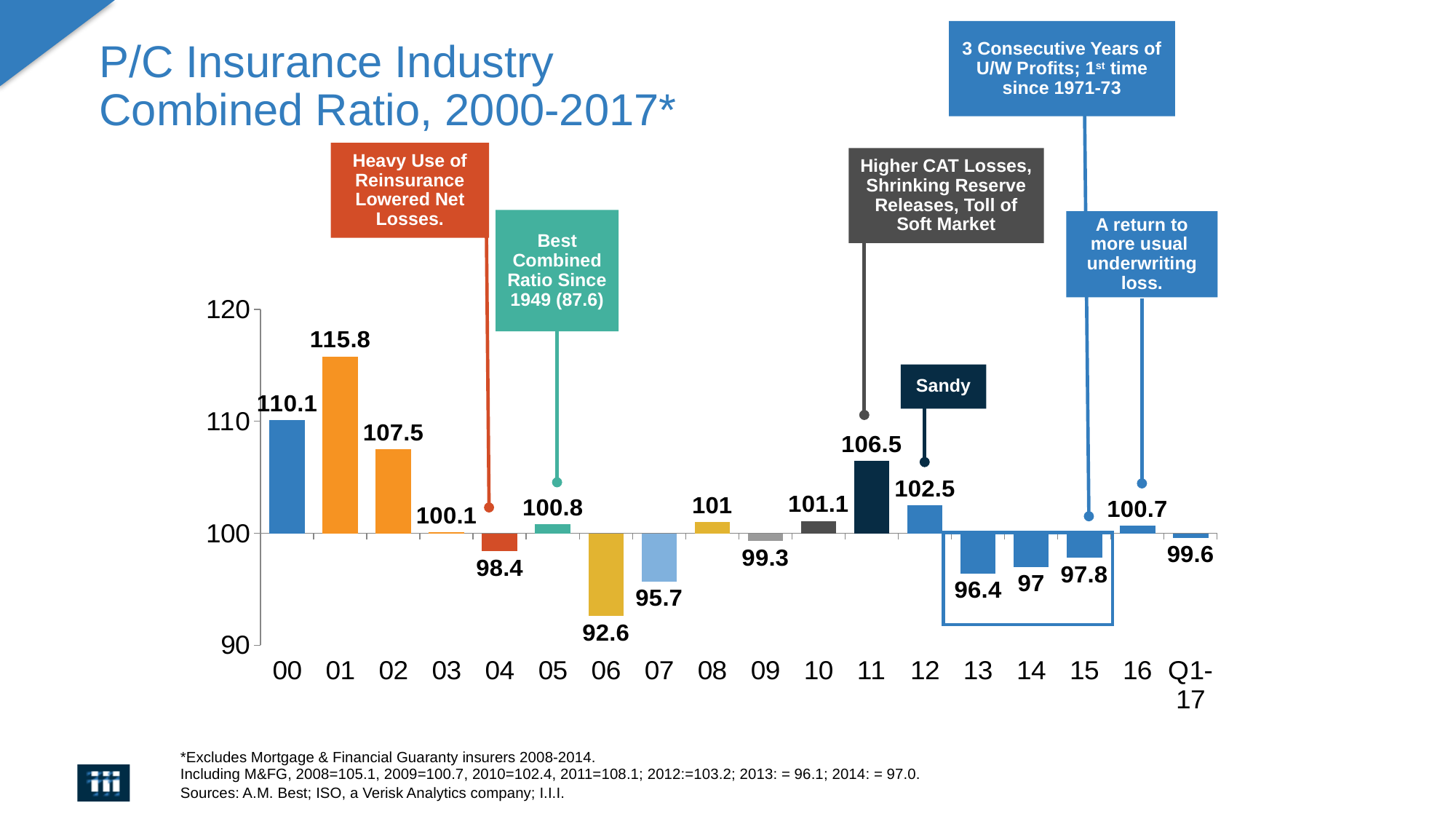
Which year has a higher combined ratio, 2007 or 2015? 15 What is the combined ratio shown for Q1-17? 99.6 What is the difference between the combined ratio for 2000 and for 2002? 2.6 What does the callout above the 2005 bar say? Best Combined Ratio Since 1949 (87.6) What is the combined ratio shown for 2012, the year labeled 'Sandy'? 102.5 What is the combined ratio shown for 2001? 115.8 What is the difference between the combined ratio for 2011 and for 2013? 10.1 What is the combined ratio shown for 2006? 92.6 Which year has the lowest combined ratio on the chart? 06 How many years or periods are plotted on the x axis? 18 What kind of chart is shown on the slide? Bar chart Which year has the highest combined ratio on the chart? 01